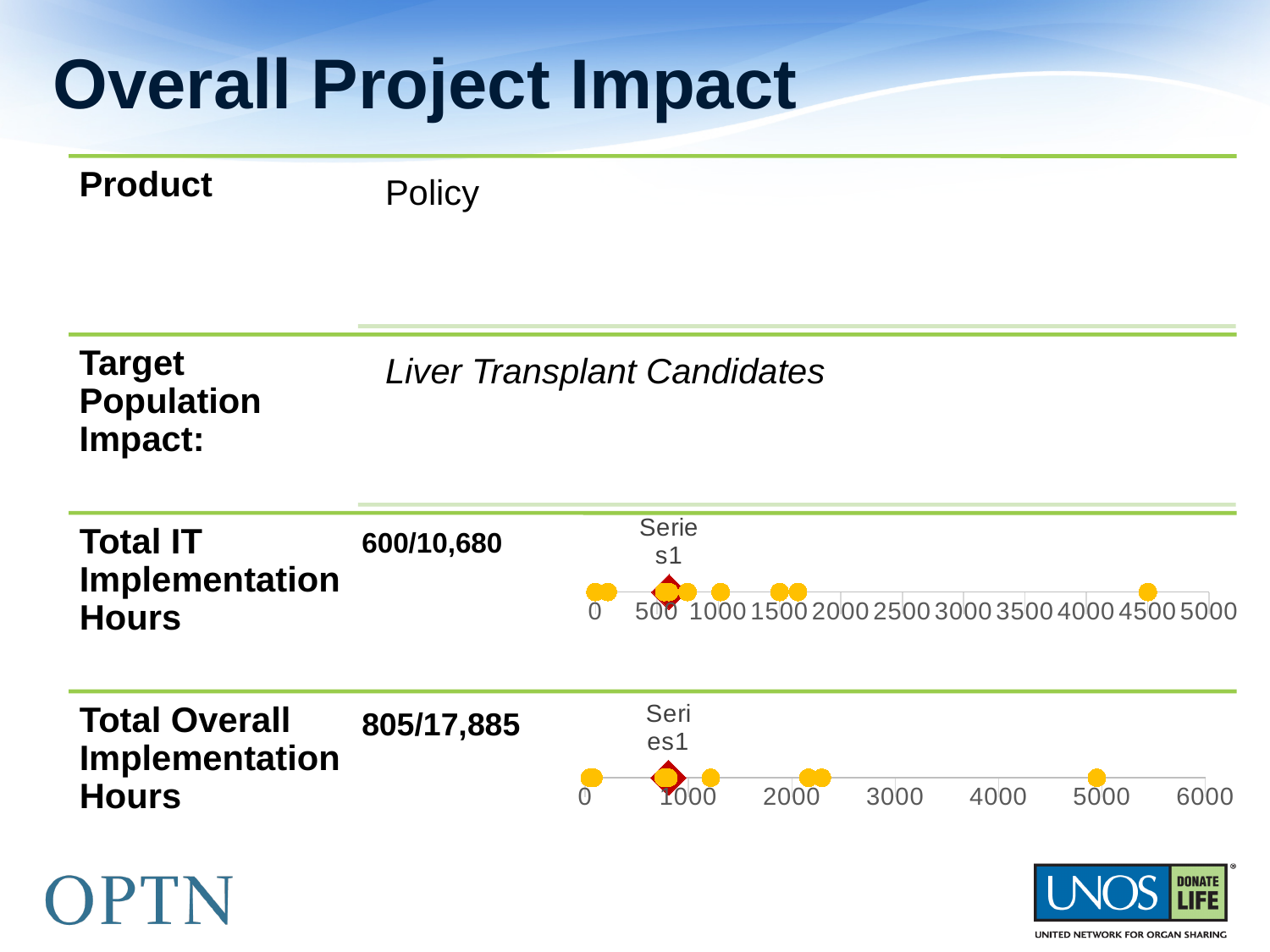
In the Total Overall Implementation Hours chart, is the rightmost point greater or less than 4000? greater What kind of chart is shown next to Total IT Implementation Hours? scatter chart What kind of chart is shown next to Total Overall Implementation Hours? scatter chart In the Total Overall Implementation Hours chart, what is the highest value labelled on the x axis? 6000 In the Total IT Implementation Hours chart, is the red diamond marker greater or less than 1000? less In the Total IT Implementation Hours chart, what is the spacing between consecutive x-axis tick labels? 500 In the Total IT Implementation Hours chart, what is the highest value labelled on the x axis? 5000 In the Total Overall Implementation Hours chart, is the rightmost point greater or less than 6000? less Which chart has the larger maximum x-axis value, the Total IT Implementation Hours chart or the Total Overall Implementation Hours chart? Total Overall Implementation Hours